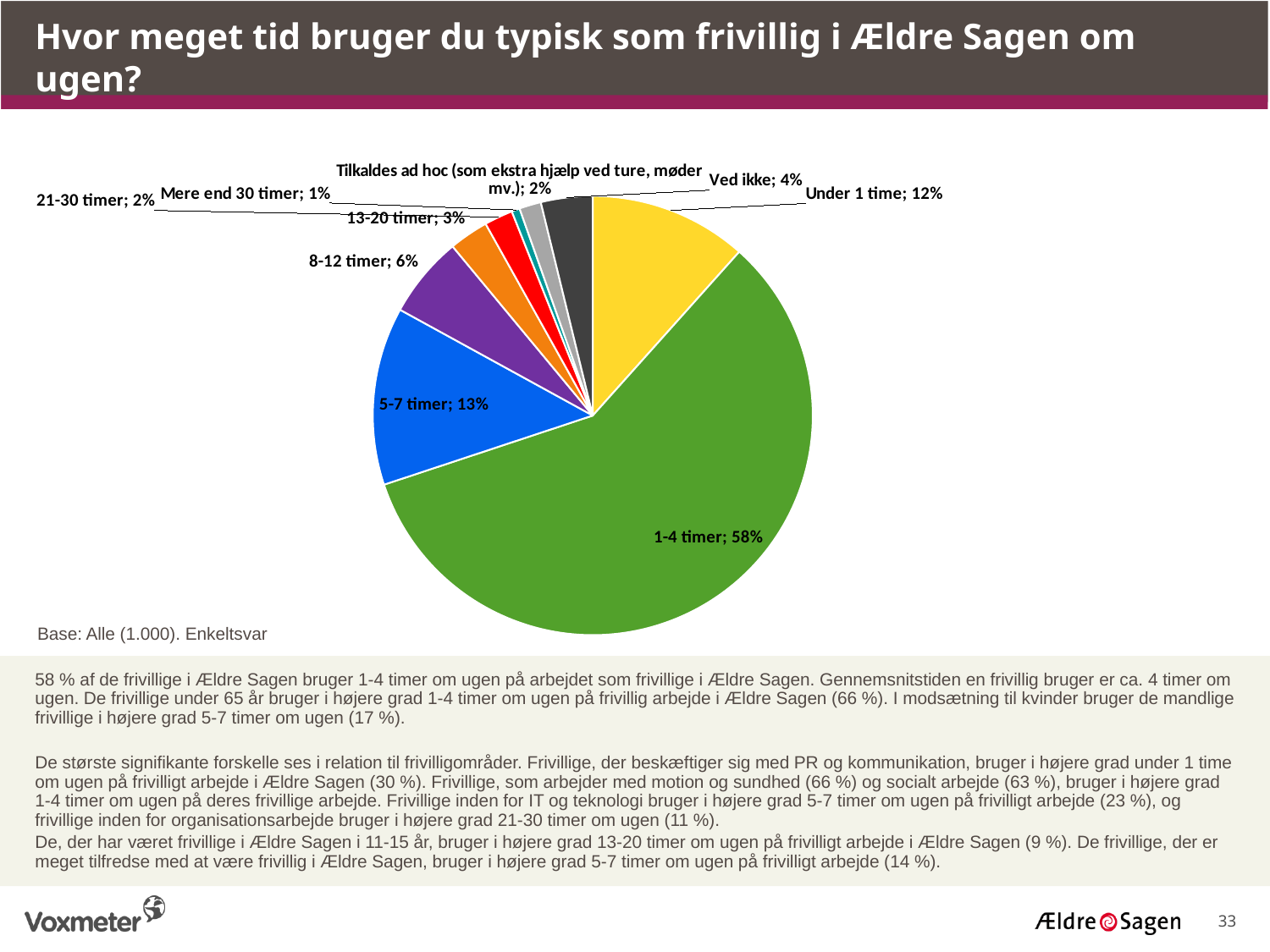
What is the value for the '8-12 timer' slice? 6% What percentage of respondents spend 1-4 timer per week as volunteers? 58% How many categories are shown in the pie chart? 9 Which category has the largest share of the pie? 1-4 timer What is the difference in percentage points between '1-4 timer' and '5-7 timer'? 45 Which category has the smallest share of the pie? Mere end 30 timer What percentage is shown for '5-7 timer'? 13% What type of chart is shown on the slide? Pie chart What is the value shown for the 'Under 1 time' slice? 12% What percentage answered 'Ved ikke'? 4% What colour is the '1-4 timer' slice? Green Which is larger, the share for 'Under 1 time' or the share for '8-12 timer'? Under 1 time